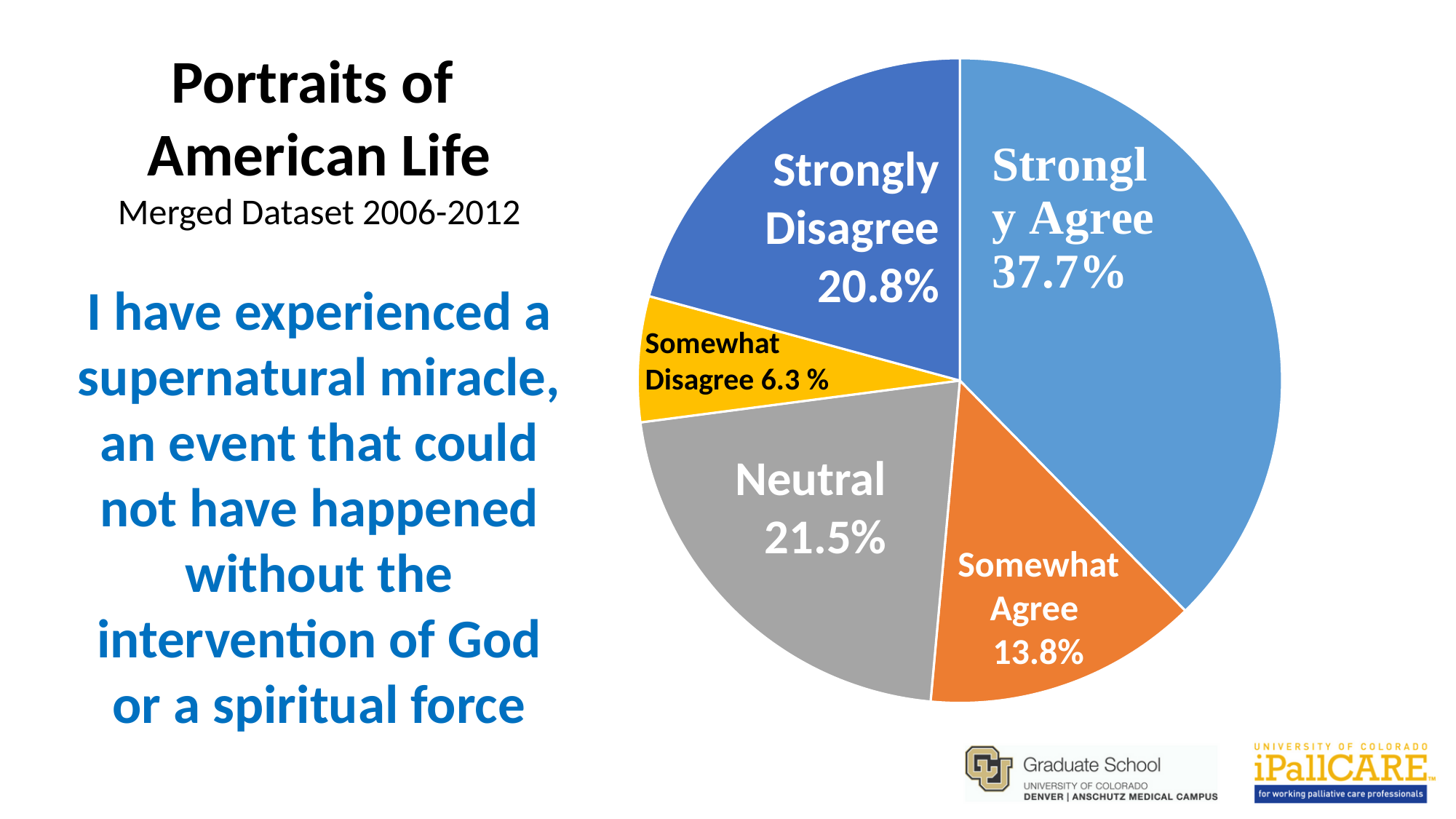
Which response category has the smallest share of the pie? Somewhat Disagree Which response category has the largest share of the pie? Strongly Agree What percentage of respondents Somewhat Disagree? 6.3 % What percentage of respondents Somewhat Agree? 13.8% What colour is the Somewhat Disagree slice? yellow What percentage of respondents Strongly Agree? 37.7% What kind of chart is shown on the slide? pie chart What percentage of respondents are Neutral? 21.5% How many slices does the pie chart have? 5 What is the difference in percentage points between Strongly Agree and Strongly Disagree? 16.9 Which is larger, the Somewhat Agree slice or the Neutral slice? Neutral What percentage of respondents Strongly Disagree? 20.8%